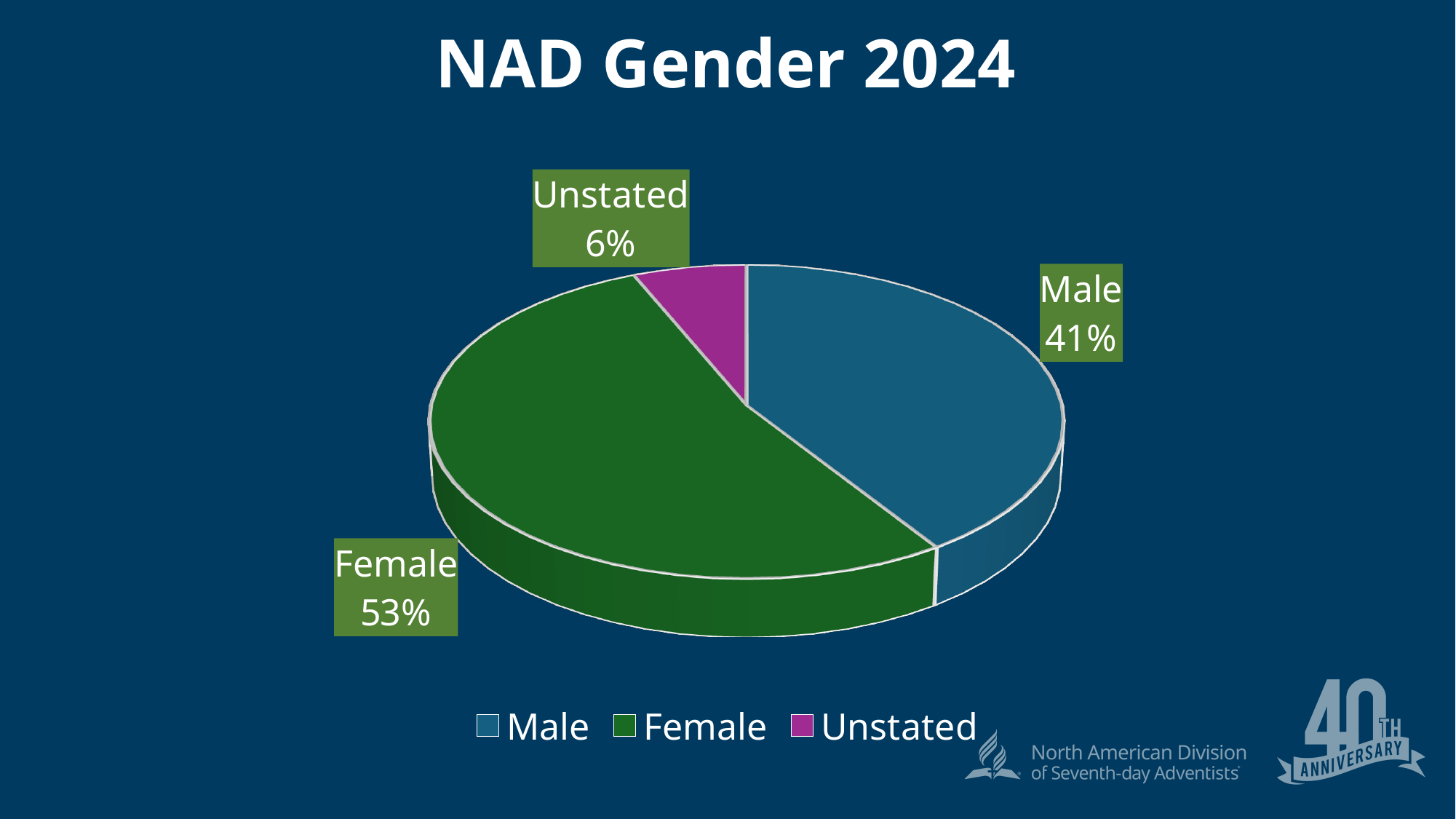
What percentage of the pie is Male? 41% Which category has the smallest share of the pie? Unstated Which is larger, the Male share or the Unstated share? Male What kind of chart is shown on the slide? Pie chart What percentage of the pie is Unstated? 6% What is the difference in percentage points between Female and Male? 12 What percentage of the pie is Female? 53% How many entries does the legend list? 3 Which category has the largest share of the pie? Female What is the title of the chart? NAD Gender 2024 What colour is the Unstated slice? Purple How many slices does the pie chart have? 3